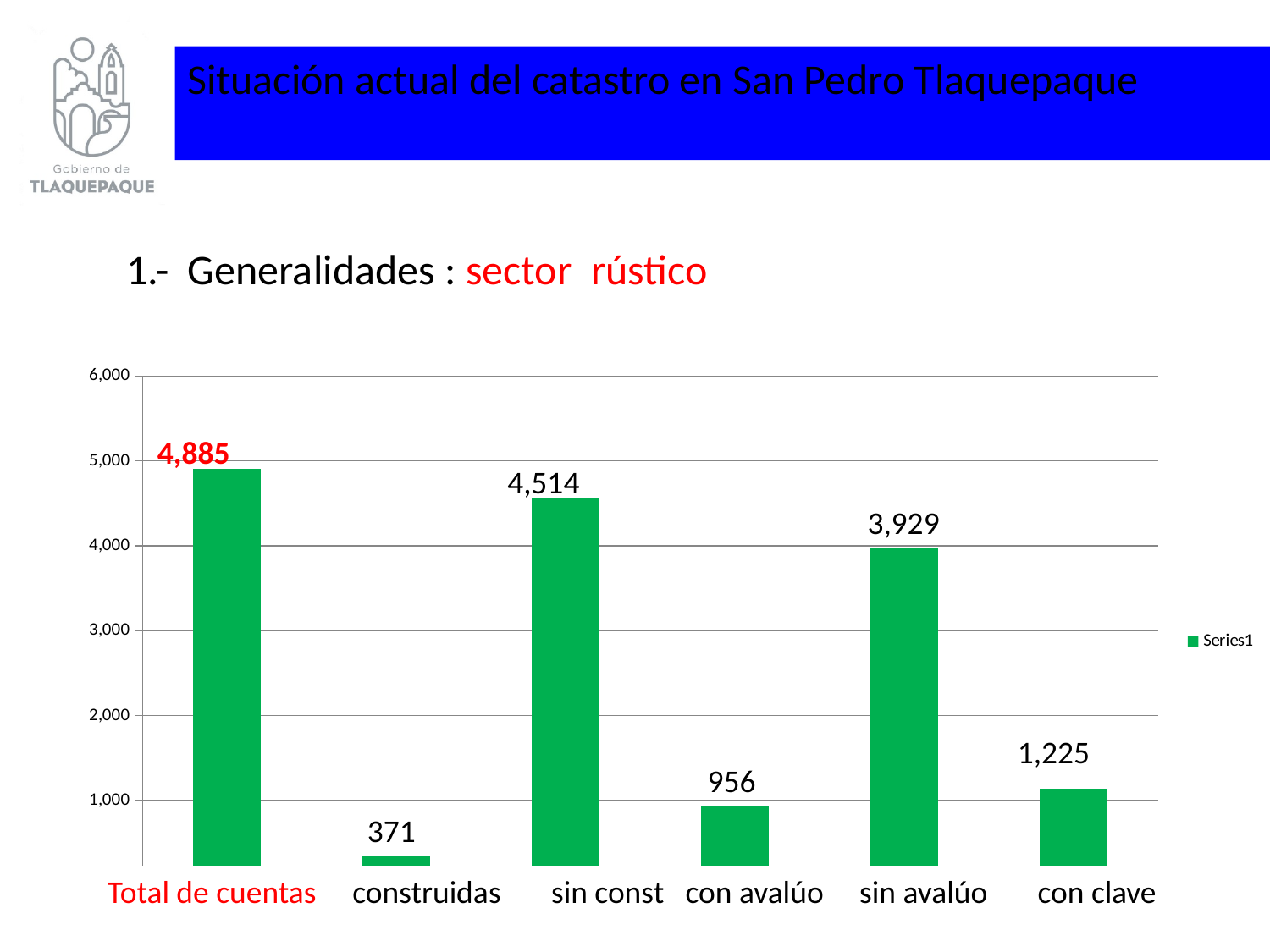
Is the value for sin avalúo greater or less than 3,000? greater What kind of chart is shown on the slide? bar chart Which is larger, the value for con avalúo or the value for con clave? con clave What is the value for con clave? 1,225 What is the value for construidas? 371 Which category has the highest value? Total de cuentas How many series does the legend list? 1 What is the value for sin avalúo? 3,929 What is the value for Total de cuentas? 4,885 How many categories are shown on the x axis? 6 What is the difference between the values for sin const and con avalúo? 3,558 Which category has the lowest value? construidas